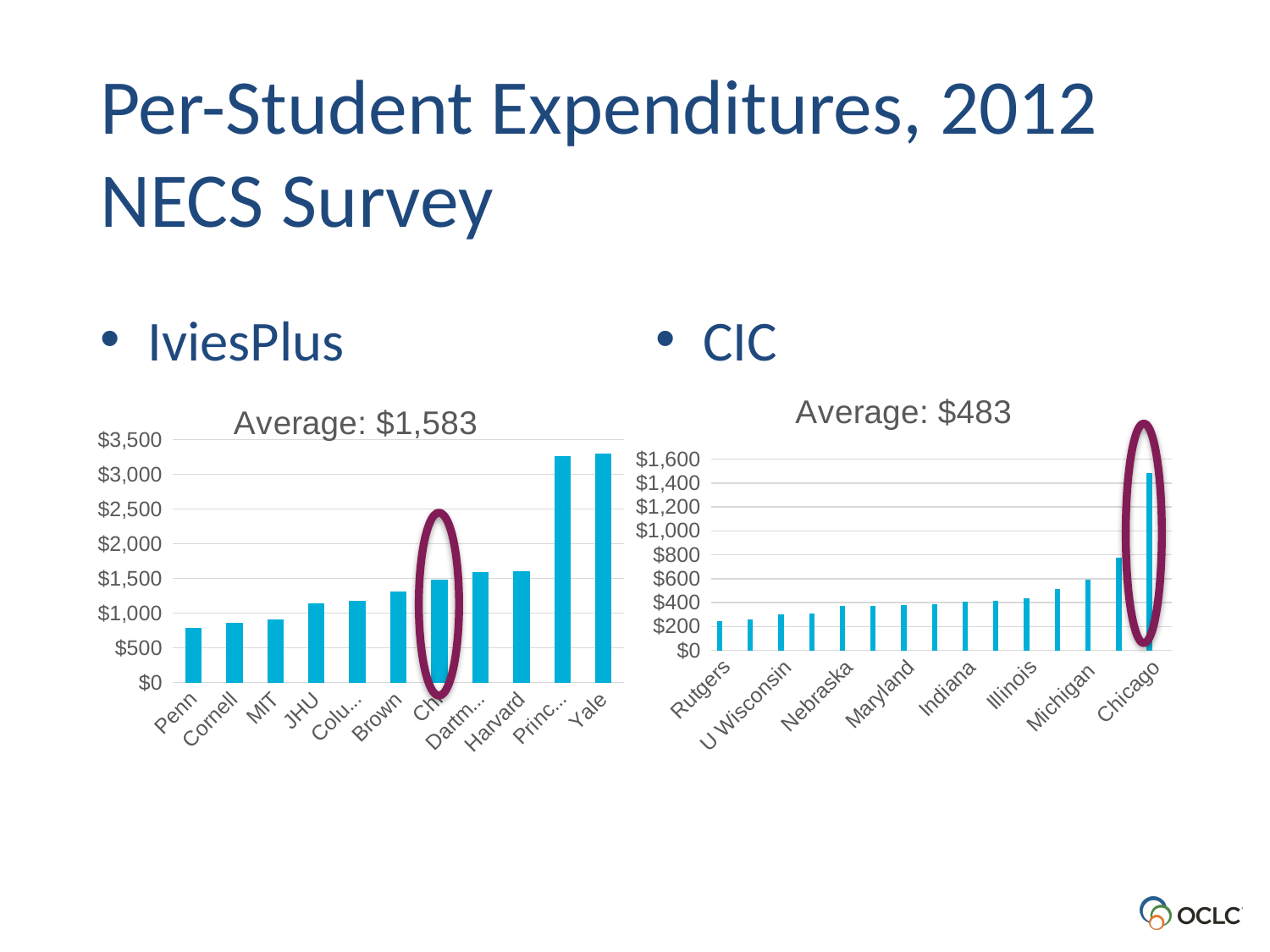
What average value is shown in the title of the IviesPlus chart on the left? $1,583 What average value is shown in the title of the CIC chart on the right? $483 In the CIC chart on the right, which has the larger value, Chicago or Michigan? Chicago In the IviesPlus chart on the left, which has the larger value, Brown or Cornell? Brown In the CIC chart on the right, is the value for Michigan greater or less than $800? less In the CIC chart on the right, is the value for Chicago greater or less than $1,000? greater In the IviesPlus chart on the left, is the value for Brown greater or less than $1,500? less What kind of chart is used for the IviesPlus data on the left? bar chart In the CIC chart on the right, which institution has the highest per-student expenditure? Chicago In the CIC chart on the right, do the values generally rise or fall from left to right along the x axis? rise